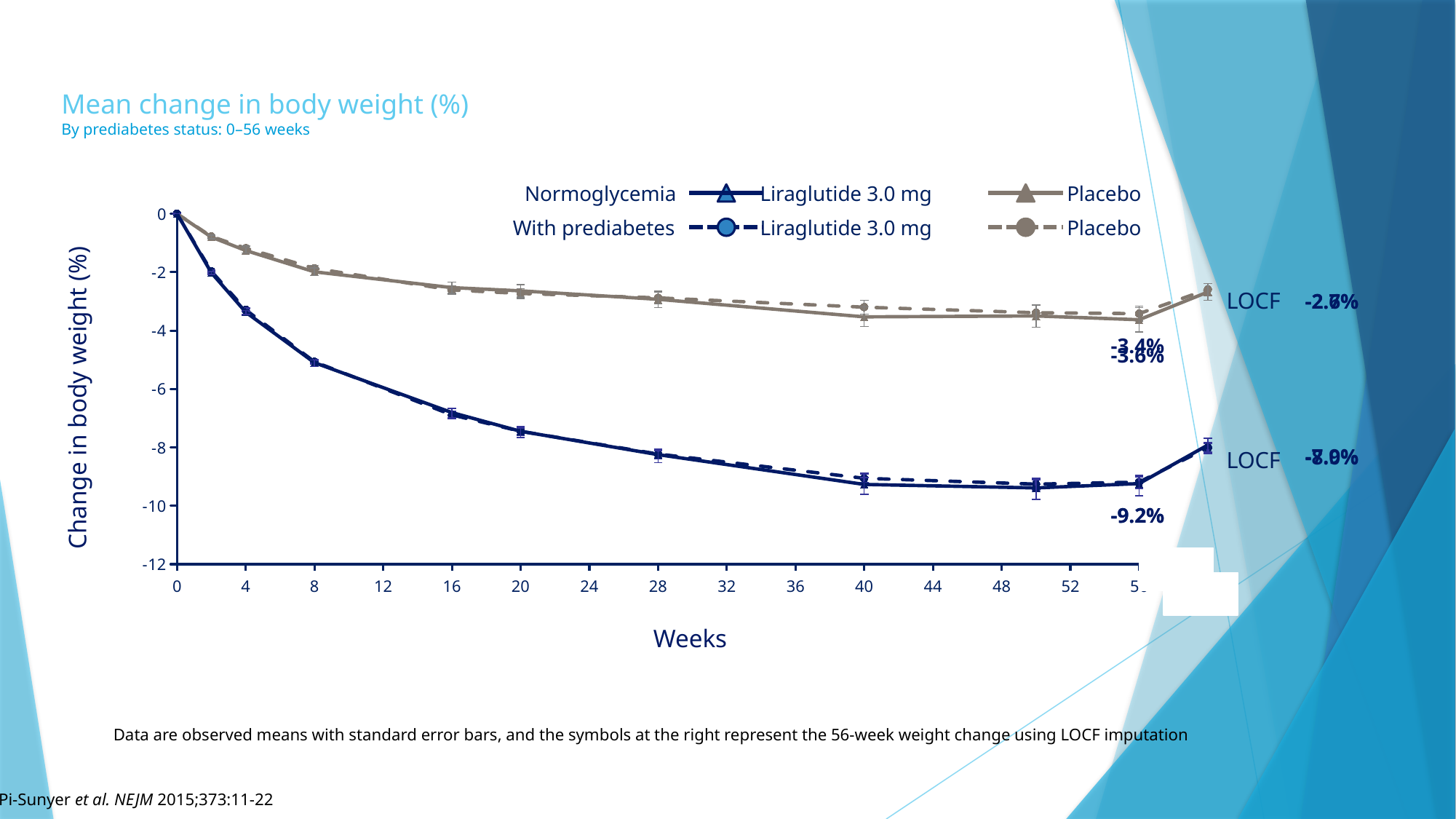
Is the Normoglycemia Placebo value at week 16 greater or less than -2? less What is the value of all series at week 0? 0 What is the lowest data label printed on the chart, shown below the Liraglutide lines near week 50? -9.2% What is the label of the x axis? Weeks Is the Normoglycemia Liraglutide 3.0 mg value at week 8 greater or less than -4? less What kind of chart is shown on the slide? line chart Do the Liraglutide 3.0 mg values rise or fall from week 0 to week 52? fall At week 28, which has the lower change in body weight: Normoglycemia Liraglutide 3.0 mg or Normoglycemia Placebo? Normoglycemia Liraglutide 3.0 mg Is the Normoglycemia Liraglutide 3.0 mg value at week 40 greater or less than -8? less How many series does the legend list? 4 What is the title of the chart? Mean change in body weight (%)